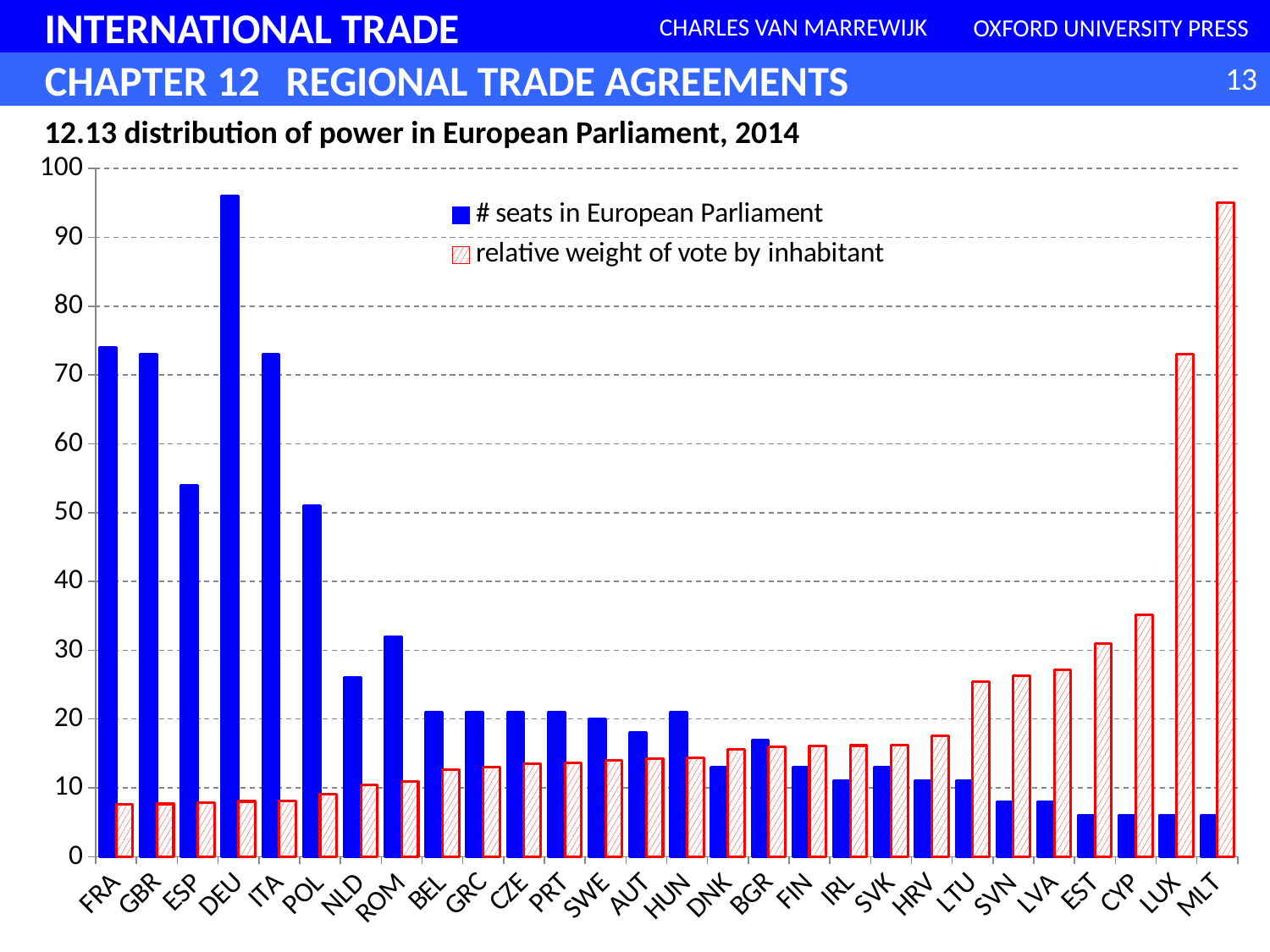
Which country has the highest relative weight of vote by inhabitant? MLT Which country has the highest number of seats in the European Parliament? DEU Which is larger for FRA: the number of seats in the European Parliament or the relative weight of vote by inhabitant? # seats in European Parliament What is the title of the chart? 12.13 distribution of power in European Parliament, 2014 Is the relative weight of vote by inhabitant for CYP greater or less than 30? greater Is the number of seats for NLD greater or less than 30? less How many series does the legend list? 2 Is the number of seats for DEU greater or less than 90? greater How many countries are shown along the x axis? 28 Do the number of seats in the European Parliament generally rise or fall moving from left to right along the x axis? fall What kind of chart is shown on the slide? bar chart